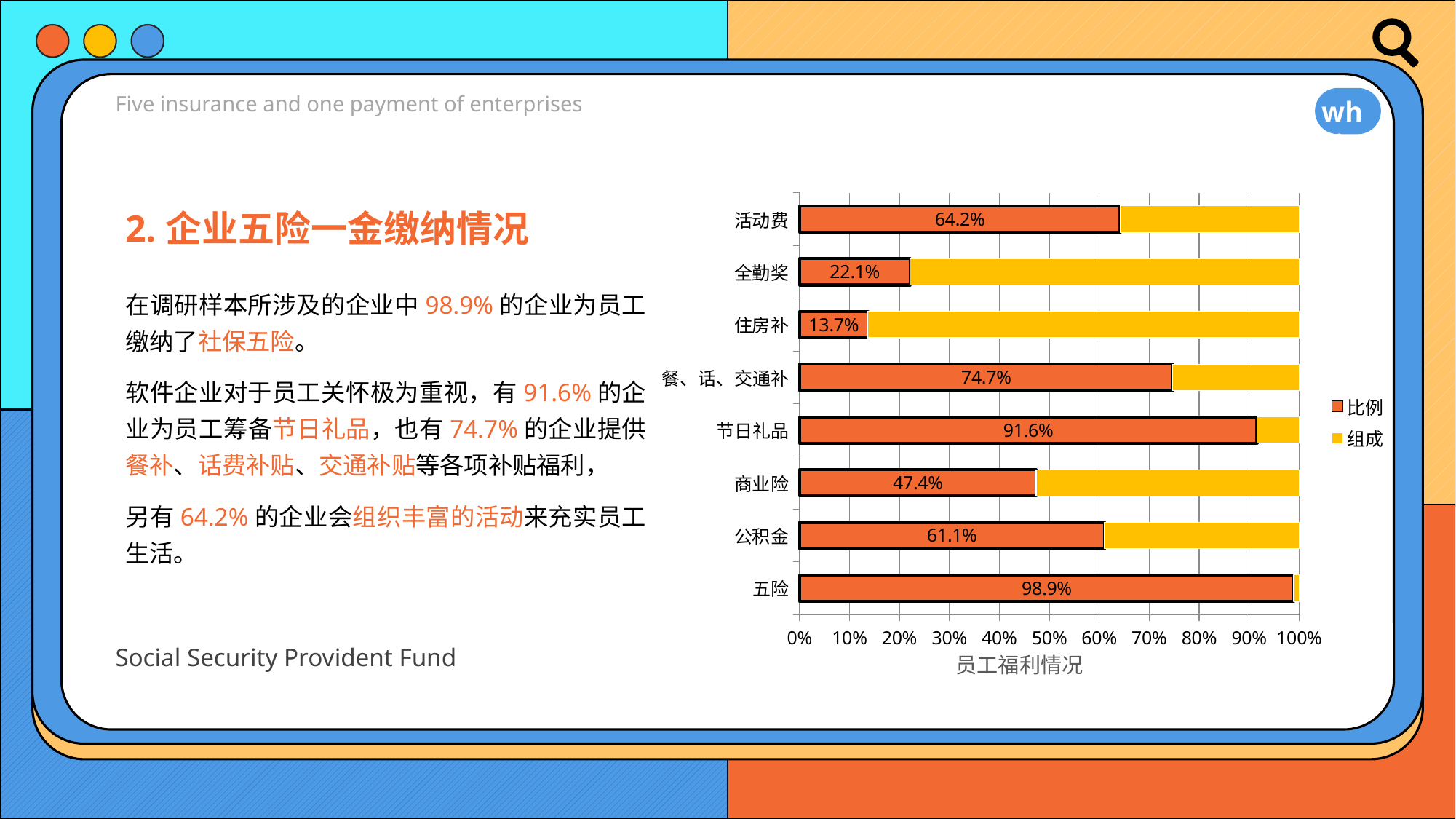
What is the difference between the 比例 values for 节日礼品 and 公积金? 30.5% How many series does the legend list? 2 Is the 比例 value for 餐、话、交通补 greater or less than 70%? greater What is the 比例 value for 商业险? 47.4% What is the 比例 value for 活动费? 64.2% Which category has the highest 比例 value? 五险 What is the 比例 value for 住房补? 13.7% What is the title shown below the chart? 员工福利情况 How many categories are shown on the chart? 8 What kind of chart is shown on the slide? stacked bar chart Which has a larger 比例 value, 全勤奖 or 商业险? 商业险 Which category has the lowest 比例 value? 住房补